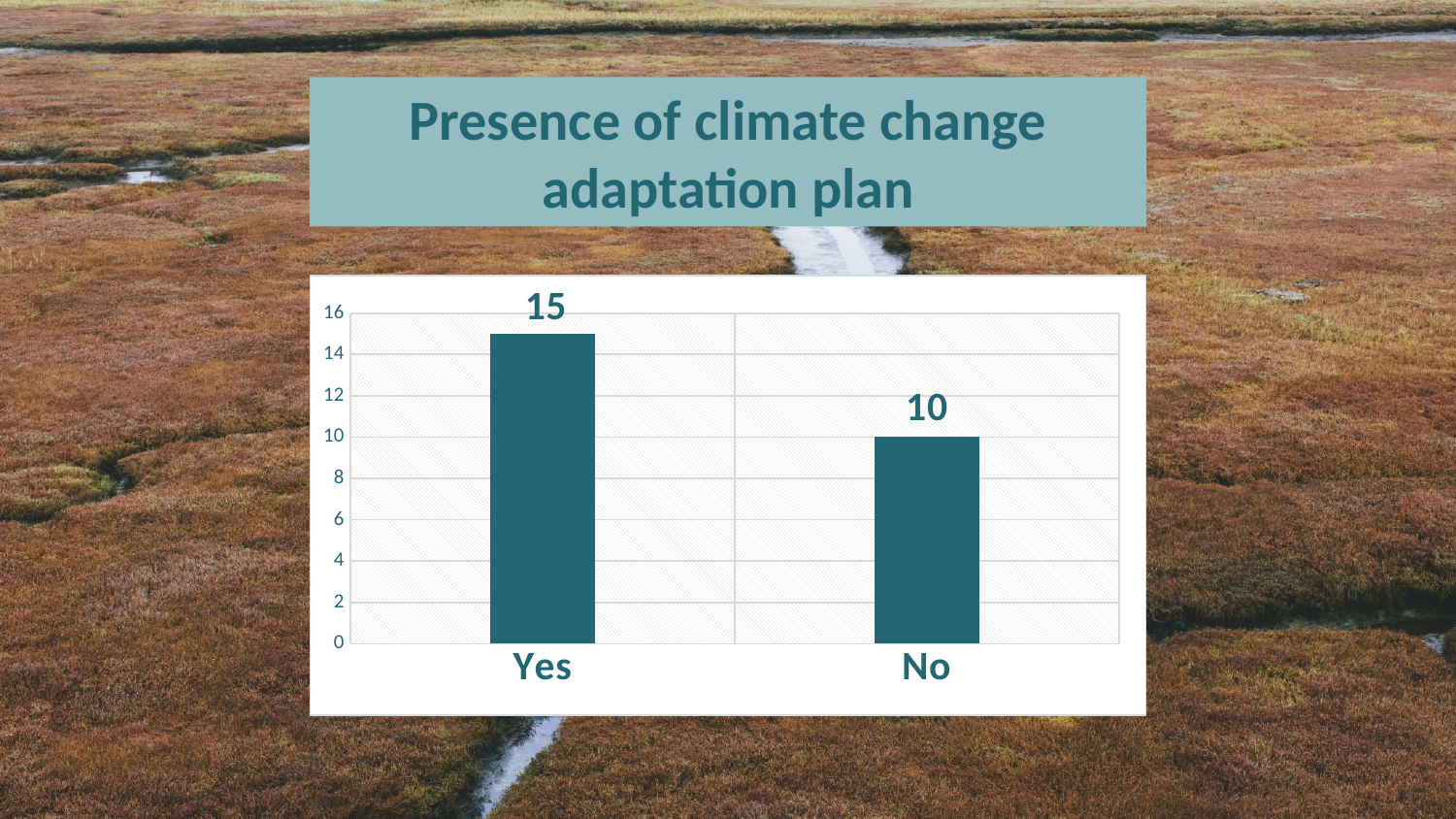
What is the title of the slide above the chart? Presence of climate change adaptation plan What is the value for No? 10 Is the value for Yes greater or less than 14? greater What is the difference between the values for Yes and No? 5 Is the value for No greater or less than 12? less What kind of chart is shown on the slide? bar chart Which category has the lowest value? No Which is larger, the value for Yes or the value for No? Yes What is the value for Yes? 15 What is the total of the values for Yes and No? 25 How many categories are shown on the x axis? 2 Which category has the highest value? Yes